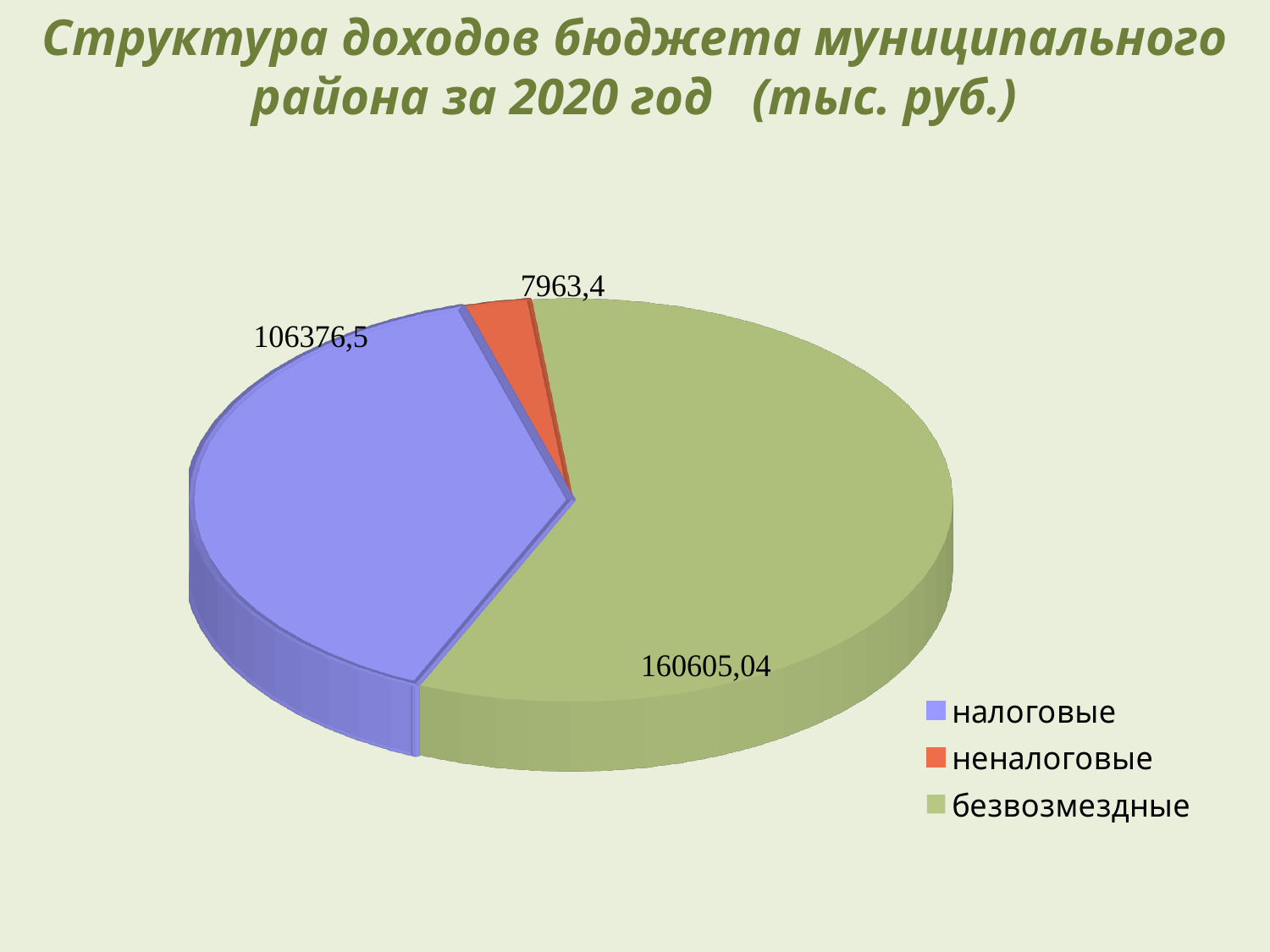
Which category has the largest slice of the pie? безвозмездные What type of chart is shown on the slide? Pie chart What is the total of all three slices? 274944,94 How many categories does the pie chart show? 3 What is the difference between the values for безвозмездные and налоговые? 54228,54 What is the difference between the values for налоговые and неналоговые? 98413,1 What is the value for безвозмездные? 160605,04 What is the value for налоговые? 106376,5 What colour is the slice for безвозмездные? Green Which category has the smallest slice of the pie? неналоговые Which is larger, налоговые or неналоговые? налоговые What is the value for неналоговые? 7963,4